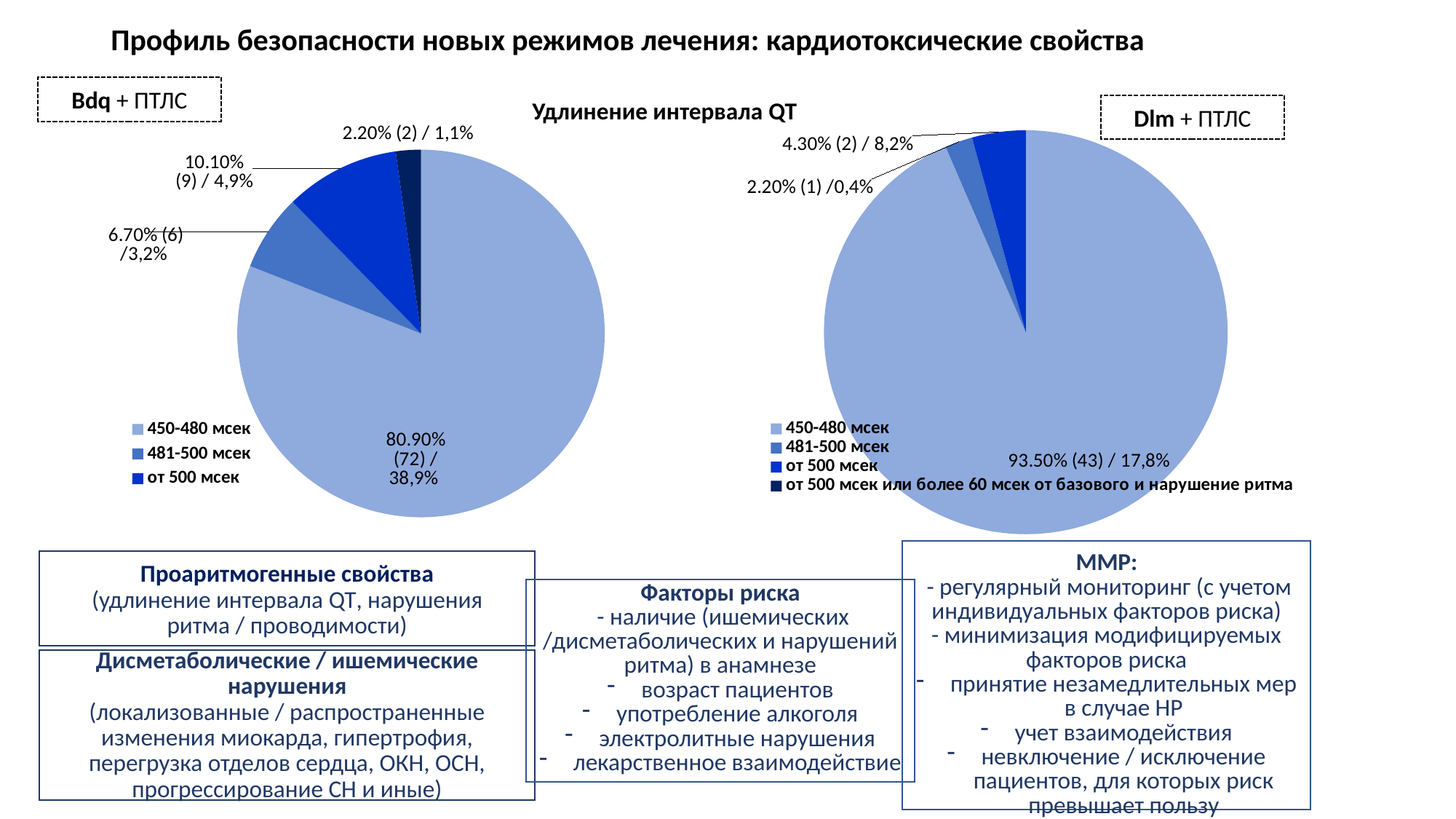
What type of charts are shown on the slide? Pie charts In the Dlm + ПТЛС pie chart, what percentage is shown for the от 500 мсек slice? 4.30% How many entries does the legend of the Dlm + ПТЛС pie chart list? 4 In the Dlm + ПТЛС pie chart, what percentage is shown for the 481-500 мсек slice? 2.20% In the Bdq + ПТЛС pie chart, which category has the largest slice? 450-480 мсек In the Bdq + ПТЛС pie chart, what percentage is shown for the 481-500 мсек slice? 6.70% Which pie chart has the larger share for 450-480 мсек, Bdq + ПТЛС or Dlm + ПТЛС? Dlm + ПТЛС What is the common title shown above the two pie charts? Удлинение интервала QT In the Dlm + ПТЛС pie chart, what is the label shown for the 450-480 мсек slice? 93.50% (43) / 17,8% In the Dlm + ПТЛС pie chart, which category has the smallest slice? 481-500 мсек In the Bdq + ПТЛС pie chart, what is the label shown for the 450-480 мсек slice? 80.90% (72) / 38,9% In the Bdq + ПТЛС pie chart, what percentage is shown for the от 500 мсек slice? 10.10%